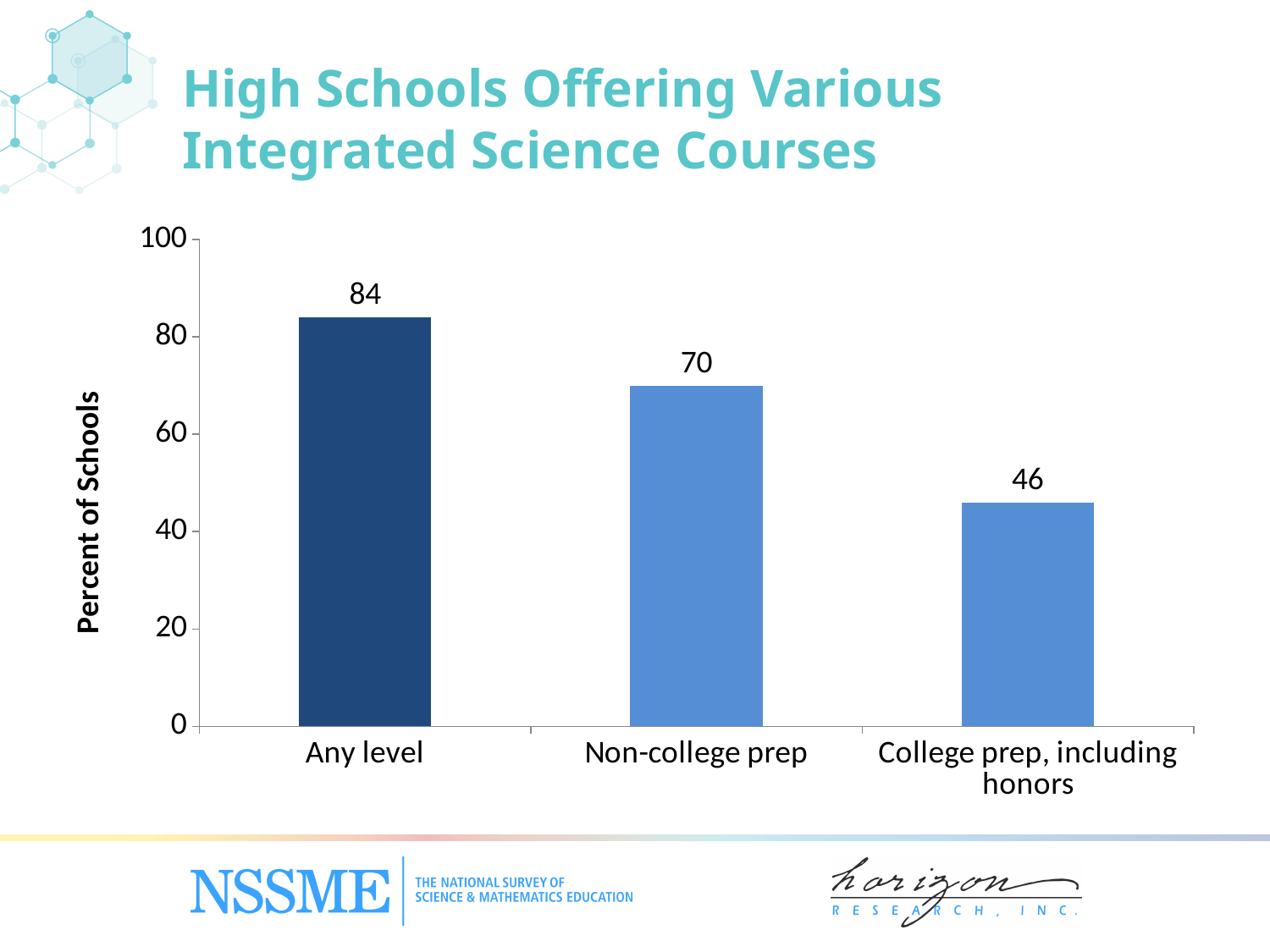
What is the label of the y axis? Percent of Schools What percent of schools offer integrated science at any level? 84 What is the value for College prep, including honors? 46 Which category has the lowest percent of schools? College prep, including honors Is the value for College prep, including honors greater or less than 60? less What is the difference between the values for Non-college prep and College prep, including honors? 24 What is the value for Non-college prep? 70 Which is larger, the value for Non-college prep or the value for College prep, including honors? Non-college prep Which category has the highest percent of schools? Any level How many categories are shown on the x axis? 3 What is the difference between the values for Any level and Non-college prep? 14 What kind of chart is shown on the slide? bar chart